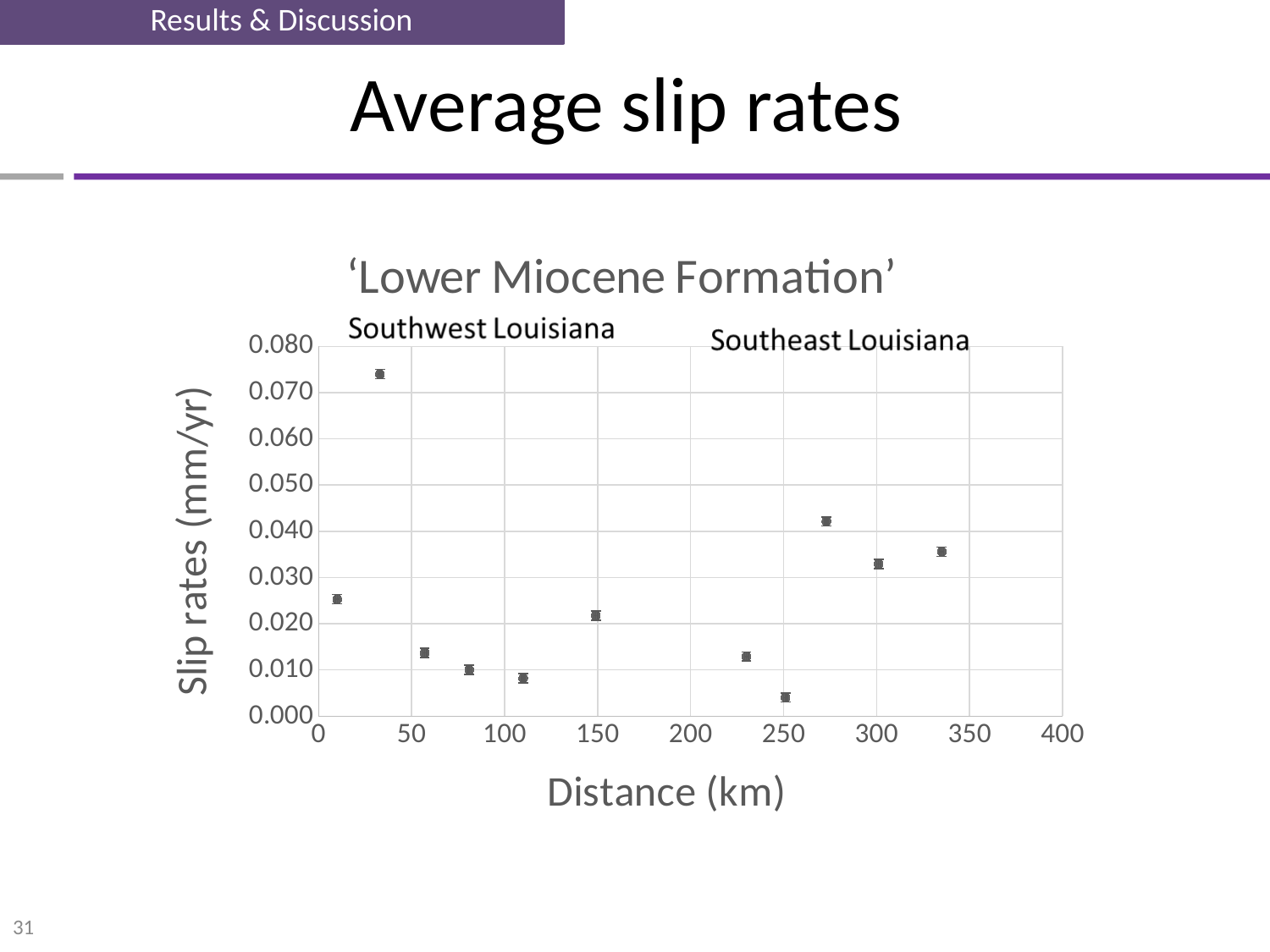
What is the label of the y axis of the chart? Slip rates (mm/yr) Is the highest slip rate plotted on the chart greater or less than 0.070 mm/yr? greater Which has the higher slip rate: the point at about 10 km or the point at about 250 km? The point at about 10 km What is the title of the chart? 'Lower Miocene Formation' How many plotted points have a slip rate above 0.030 mm/yr? 4 Is the slip rate for the point at about 110 km greater or less than 0.010 mm/yr? less Is the slip rate for the point at about 275 km greater or less than 0.040 mm/yr? greater How many data points are plotted on the chart? 11 Which has the higher slip rate: the point at about 275 km or the point at about 300 km? The point at about 275 km What kind of chart is shown on the slide? Scatter chart